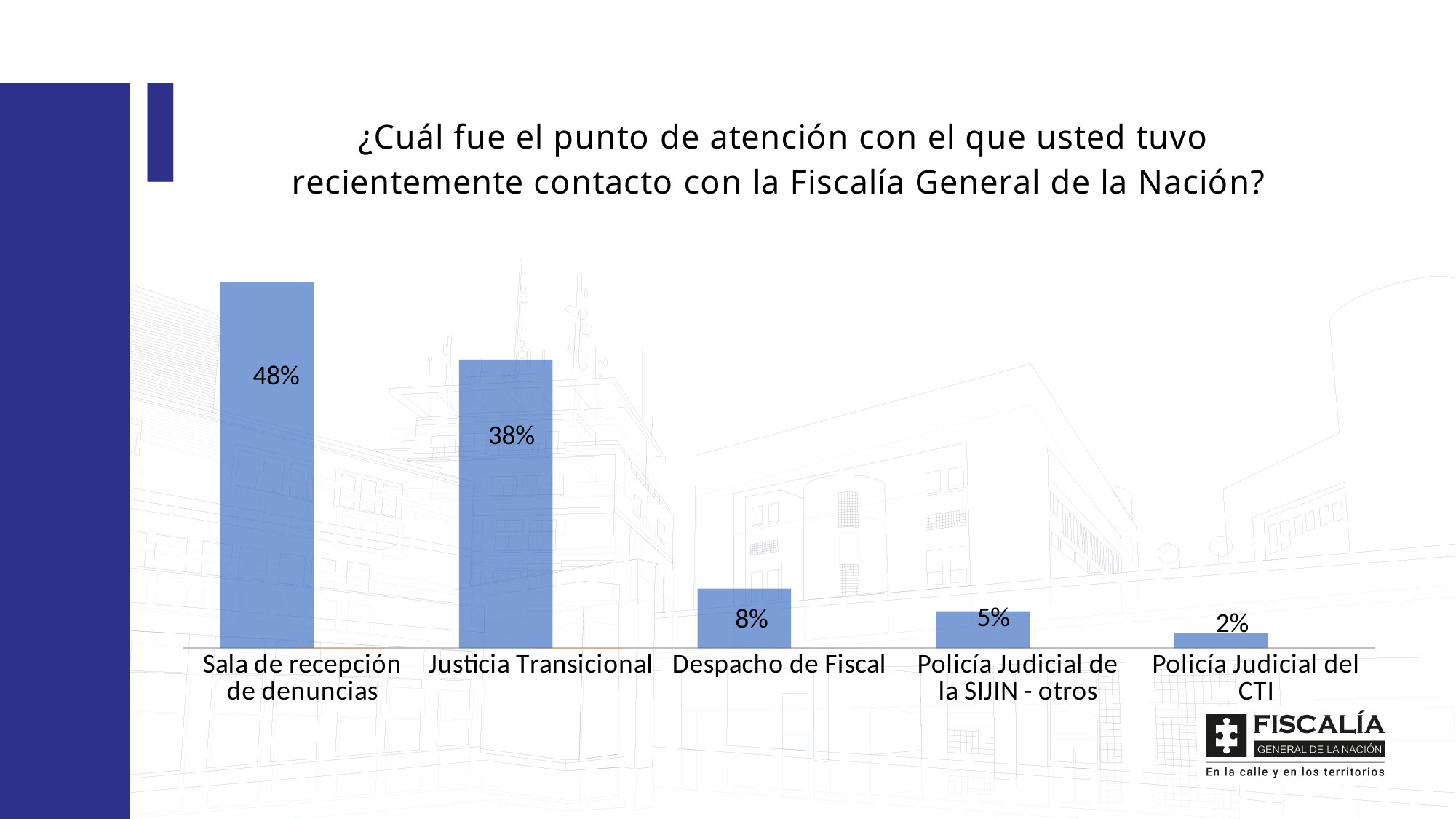
What is the value for Justicia Transicional? 38% What is the value for Despacho de Fiscal? 8% What kind of chart is shown on the slide? Bar chart Do the values rise or fall from left to right along the x axis? Fall Which category has the lowest value? Policía Judicial del CTI Which is larger, Despacho de Fiscal or Policía Judicial de la SIJIN - otros? Despacho de Fiscal How many categories are shown in the chart? 5 Which category has the highest value? Sala de recepción de denuncias What is the value for Sala de recepción de denuncias? 48% What is the value for Policía Judicial de la SIJIN - otros? 5% What is the value for Policía Judicial del CTI? 2% What is the difference between Sala de recepción de denuncias and Justicia Transicional? 10%